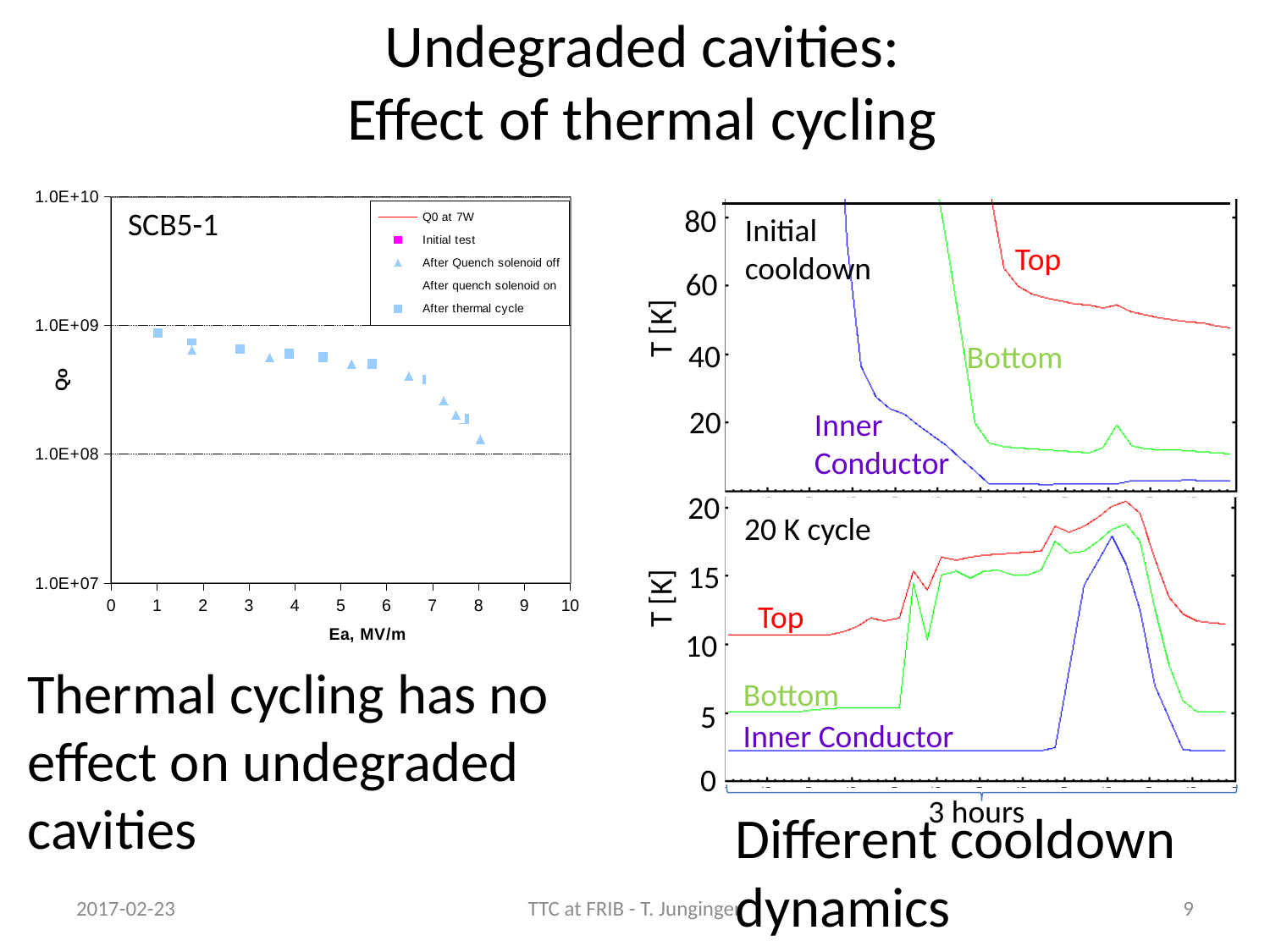
In the 'Initial cooldown' chart, which series has the lowest temperature at the right end of the plot? Inner Conductor In the SCB5-1 chart, is the Q0 value at Ea of about 1 MV/m greater or less than 1.0E+08? greater What is the x-axis label of the SCB5-1 chart? Ea, MV/m How many entries does the legend of the SCB5-1 chart list? 5 In the SCB5-1 chart, do the Q0 values rise or fall as Ea increases? fall In the '20 K cycle' chart, is the peak Inner Conductor temperature greater or less than 15? greater In the 'Initial cooldown' chart, which series has the highest temperature at the right end of the plot? Top In the 'Initial cooldown' chart, is the Top temperature at the right end of the plot greater or less than 60? less In the '20 K cycle' chart, which is larger at the start of the plot, the Top temperature or the Bottom temperature? Top How many charts are shown on the slide? 3 What kind of chart is the SCB5-1 chart on the left of the slide? scatter chart